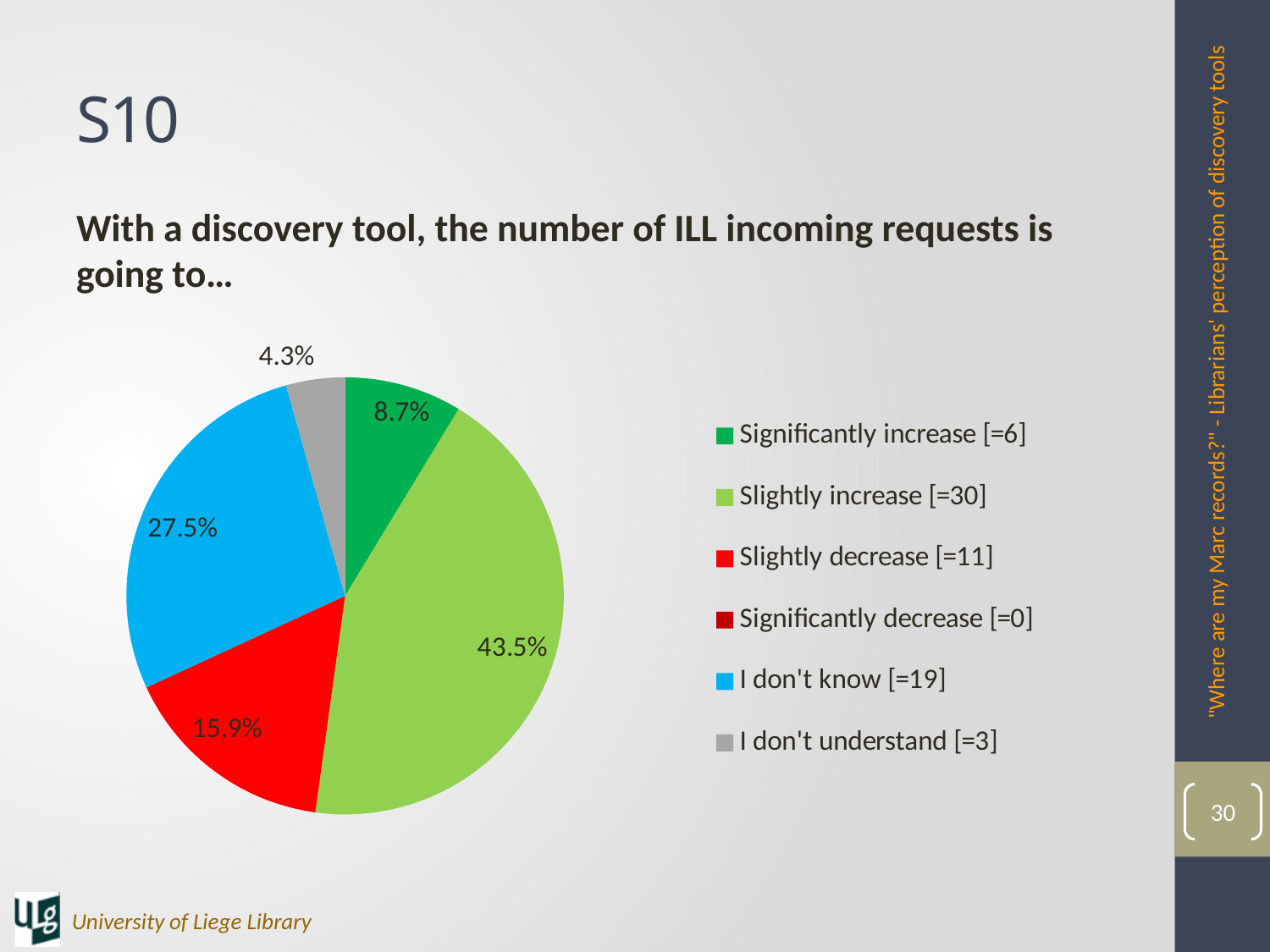
According to the legend, how many respondents chose 'Significantly decrease'? 0 How many entries does the legend list? 6 Which category has the largest share of the pie? Slightly increase What kind of chart is shown on the slide? pie chart What percentage of the pie is labelled for 'Slightly increase'? 43.5% What percentage of the pie is labelled for 'I don't know'? 27.5% Which category with a visible slice has the smallest share of the pie? I don't understand What percentage of the pie is labelled for 'Slightly decrease'? 15.9% Which is larger, the share for 'Slightly decrease' or the share for 'Significantly increase'? Slightly decrease What percentage of the pie is labelled for 'Significantly increase'? 8.7% What is the difference in percentage points between 'Slightly increase' and 'I don't know'? 16 What percentage of the pie is labelled for 'I don't understand'? 4.3%